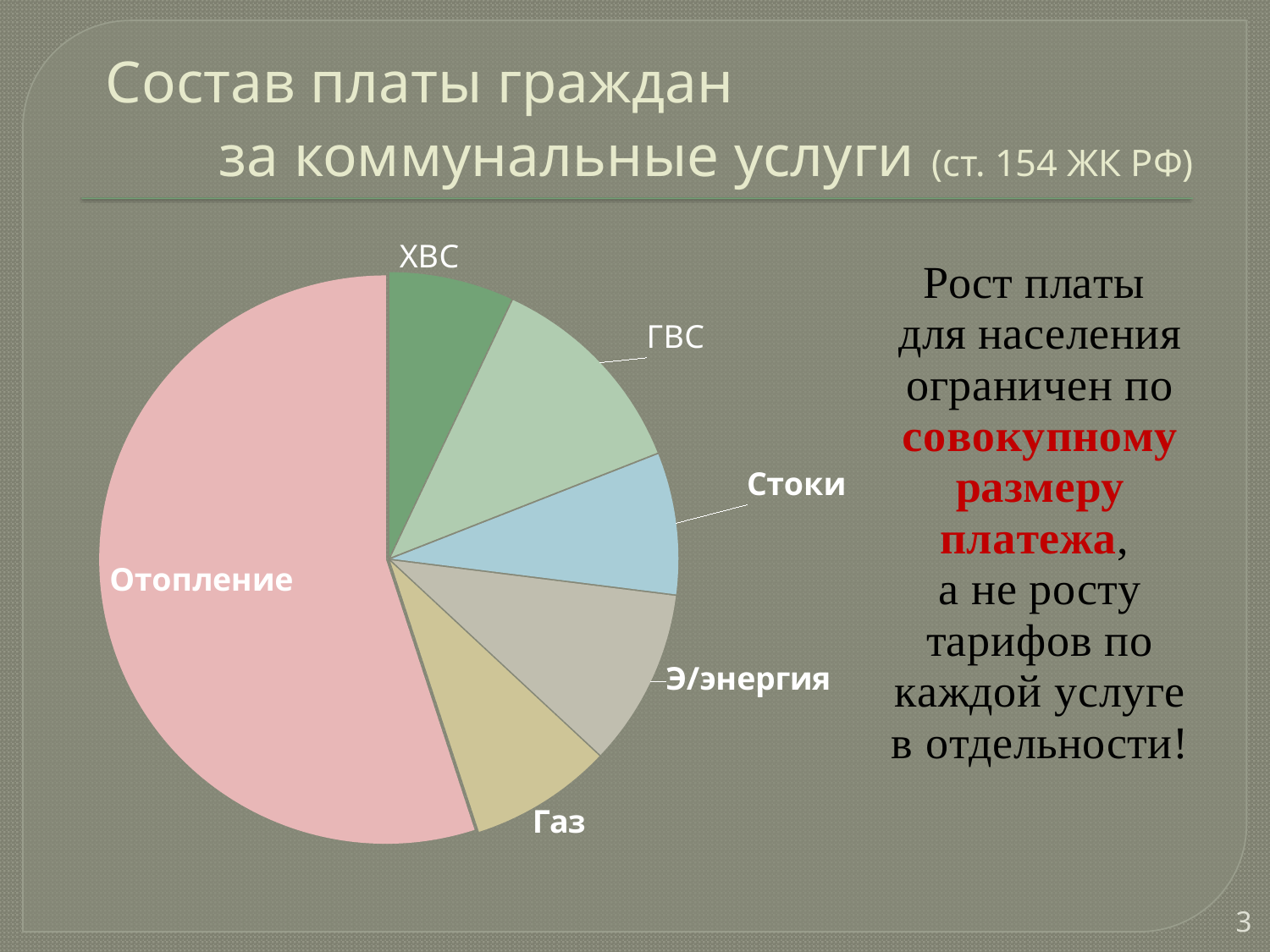
Which slice is larger, Отопление or ГВС? Отопление Does the Отопление slice take up more or less than half of the pie? more What is the title of the slide containing the pie chart? Состав платы граждан за коммунальные услуги (ст. 154 ЖК РФ) What kind of chart is shown on the slide? pie chart How many slices does the pie chart have? 6 Which category has the largest slice of the pie chart? Отопление Which slice is larger, Отопление or Газ? Отопление What colour is the Отопление slice in the pie chart? pink Which slice is larger, ГВС or ХВС? ГВС